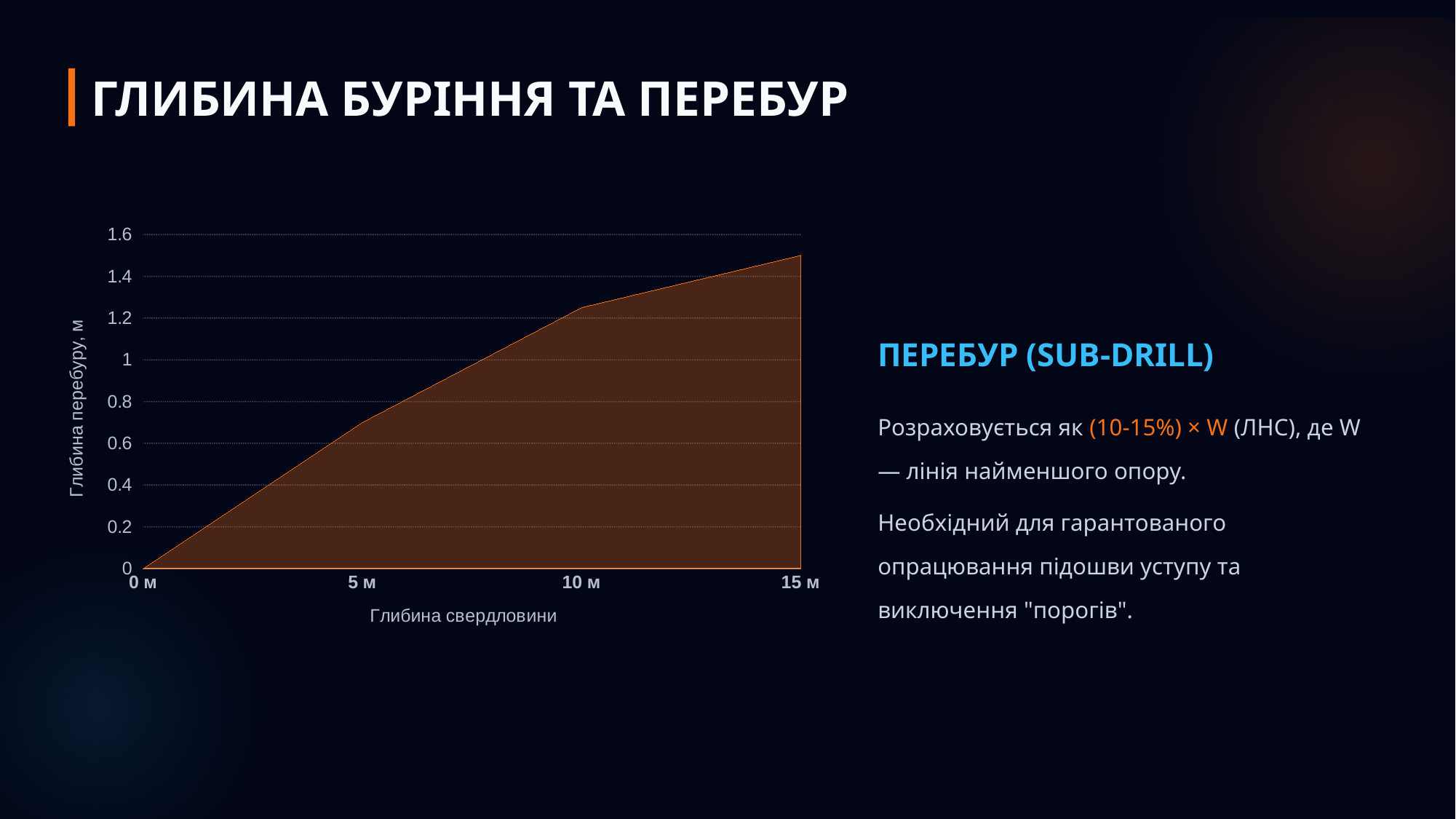
What is the title of the chart's x axis? Глибина свердловини Is the value for 5 м greater or less than 0.6? greater Is the value for 15 м greater or less than 1.4? greater What is the value of the chart at 0 м? 0 Which x-axis point has the highest value in the chart? 15 м Do the values in the chart rise or fall as the x axis goes from 0 м to 15 м? rise Is the value for 15 м greater or less than 1.6? less Which is larger, the value at 5 м or the value at 10 м? 10 м What kind of chart is shown on the slide? area chart How many points are plotted along the x axis of the chart? 4